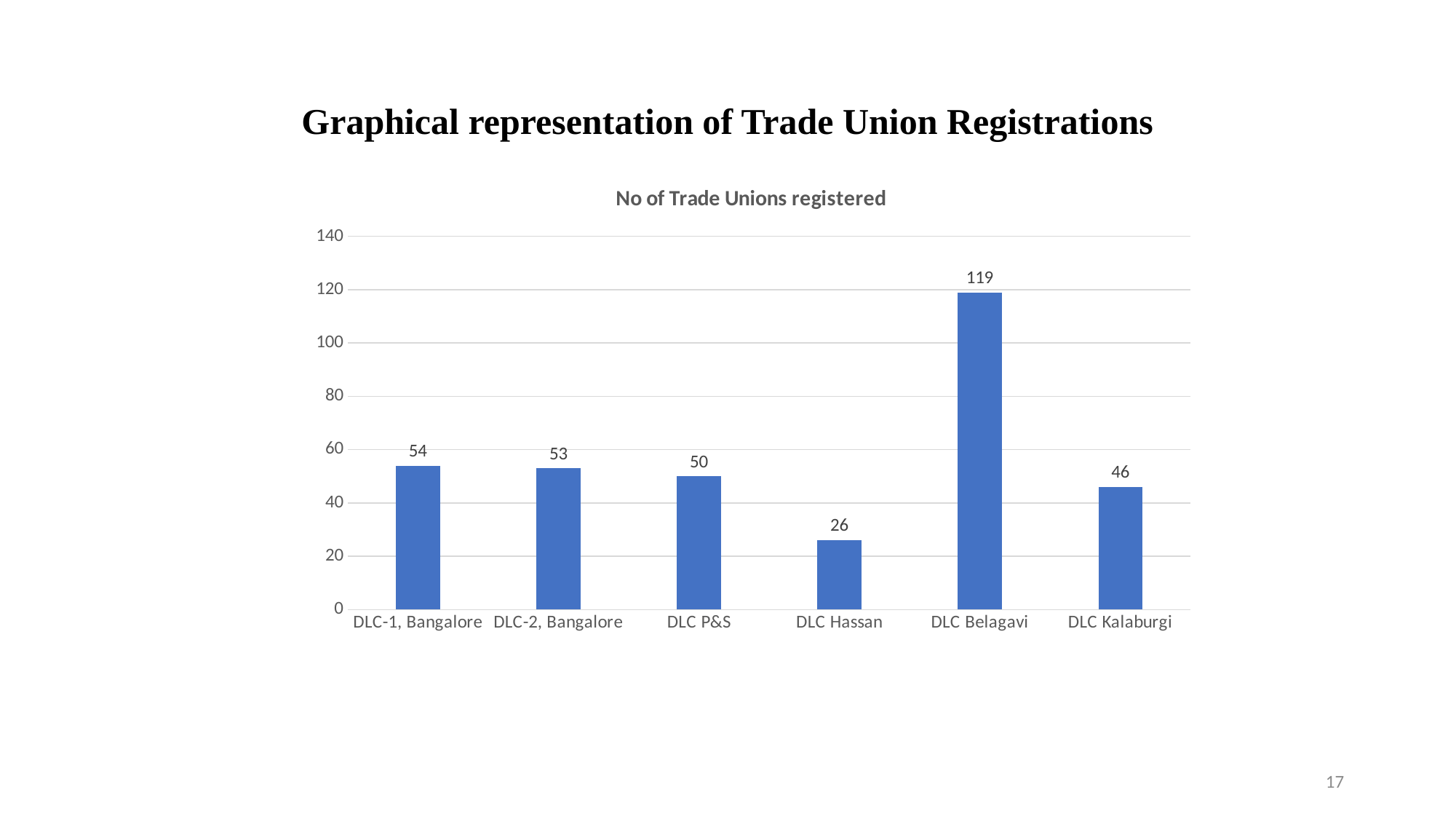
What is the difference between the values for DLC-1, Bangalore and DLC Kalaburgi? 8 What is the number of trade unions registered for DLC Belagavi? 119 What kind of chart is shown on the slide? bar chart What is the difference between the values for DLC Belagavi and DLC Hassan? 93 What is the number of trade unions registered for DLC P&S? 50 What is the number of trade unions registered for DLC Kalaburgi? 46 Is the value for DLC Belagavi greater or less than 100? greater Which is larger, the value for DLC P&S or the value for DLC Kalaburgi? DLC P&S What is the number of trade unions registered for DLC Hassan? 26 Which category has the highest number of trade unions registered? DLC Belagavi How many categories are shown on the x axis of the chart? 6 Which category has the lowest number of trade unions registered? DLC Hassan